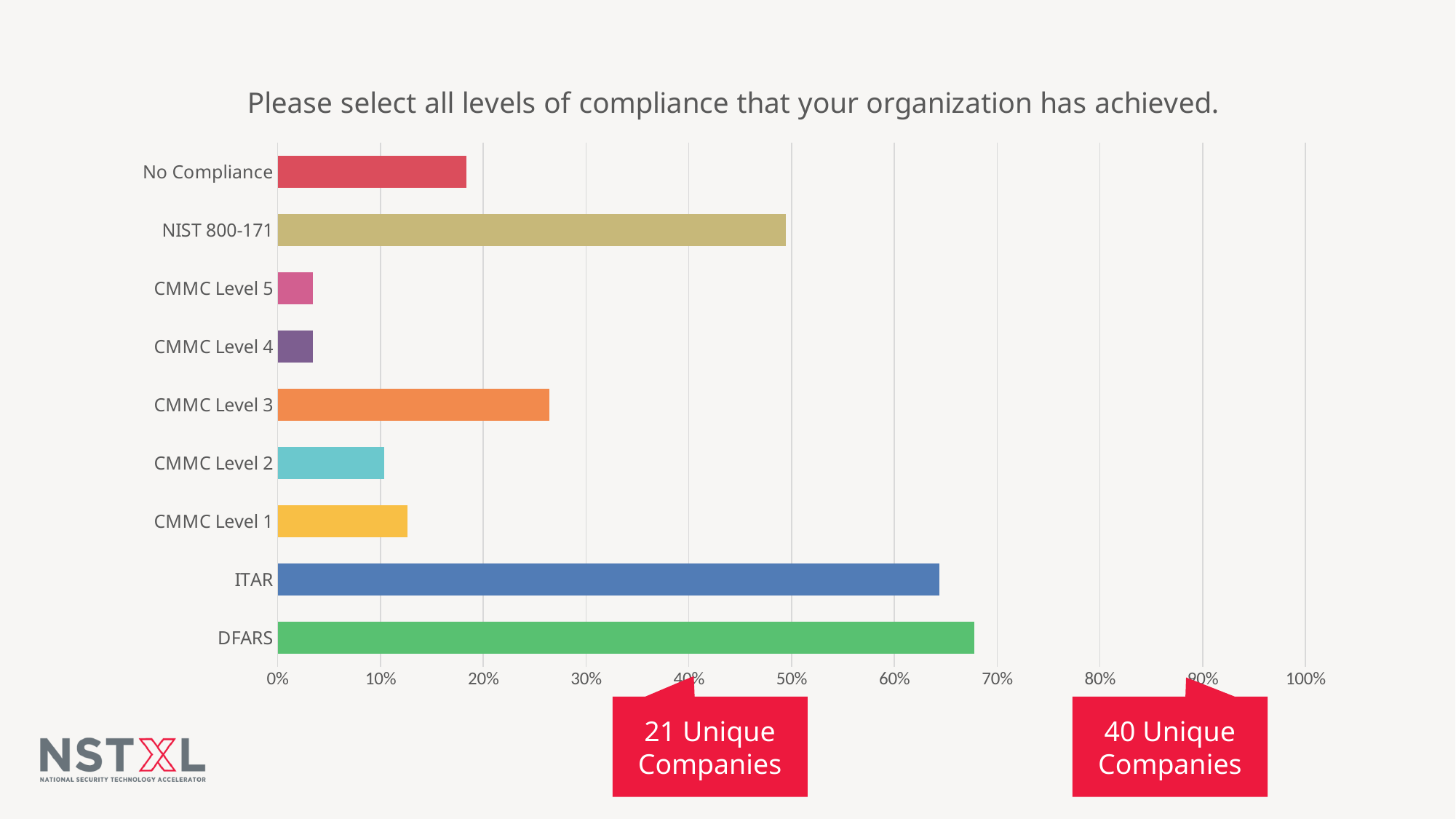
Which is larger, the value for CMMC Level 3 or the value for CMMC Level 1? CMMC Level 3 How many compliance categories are plotted in the chart? 9 Is the value for ITAR greater or less than 60%? greater Is the value for NIST 800-171 greater or less than 40%? greater Is the value for CMMC Level 2 greater or less than 20%? less Which compliance category has the highest value? DFARS Which is larger, the value for ITAR or the value for NIST 800-171? ITAR What kind of chart is shown on the slide? Bar chart What is the title of the chart? Please select all levels of compliance that your organization has achieved.